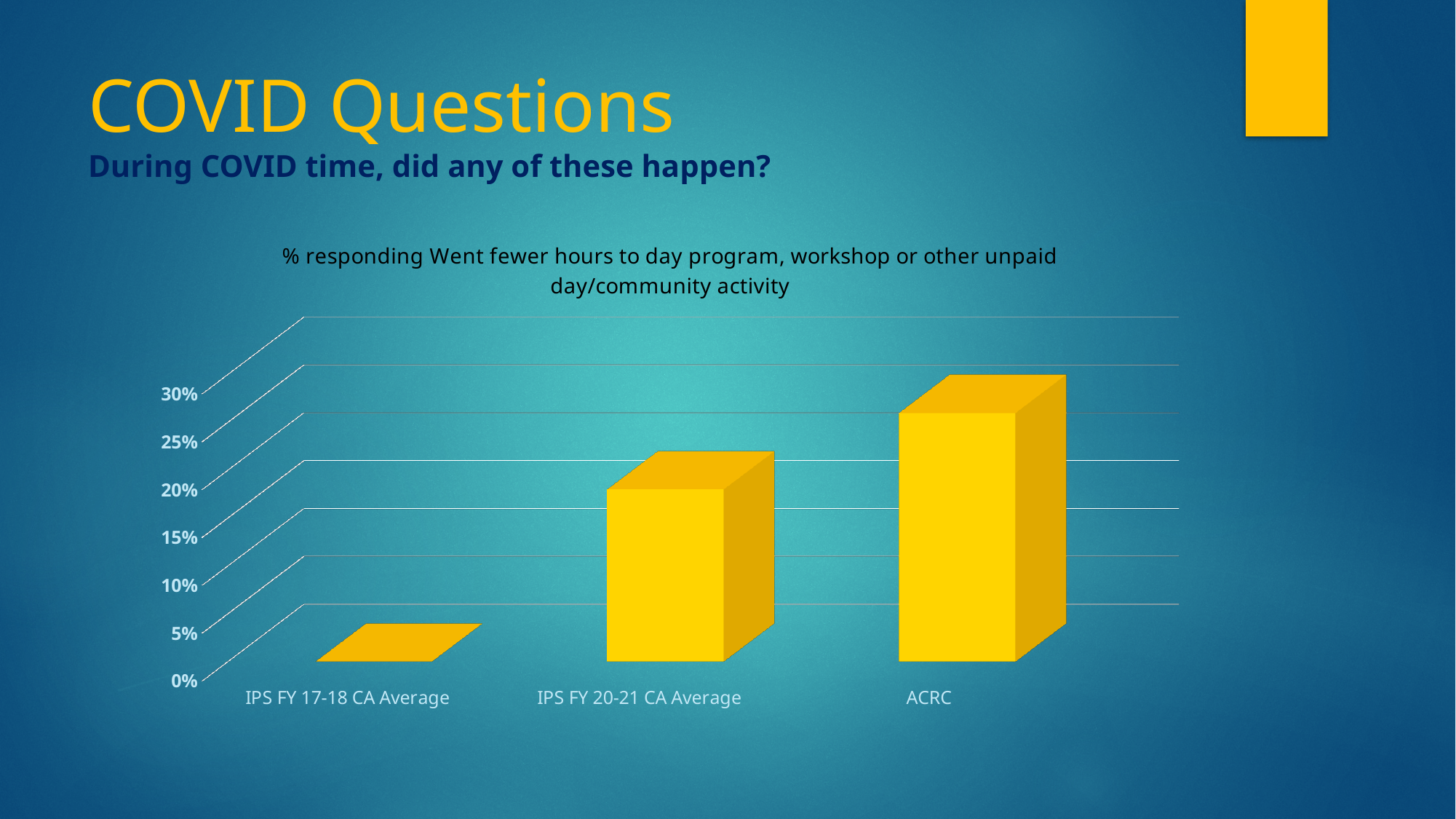
What kind of chart is shown on the slide? bar chart Which category has the lowest value in the chart? IPS FY 17-18 CA Average Is the value for IPS FY 20-21 CA Average greater or less than 10%? greater Do the values rise or fall moving from left to right across the categories? rise Is the value for ACRC greater or less than 20%? greater Which is larger, the value for ACRC or the value for IPS FY 20-21 CA Average? ACRC How many categories are plotted in the chart? 3 Which is larger, the value for IPS FY 20-21 CA Average or the value for IPS FY 17-18 CA Average? IPS FY 20-21 CA Average What is the title of the chart? % responding Went fewer hours to day program, workshop or other unpaid day/community activity Is the value for IPS FY 17-18 CA Average greater or less than 5%? less Which category has the highest value in the chart? ACRC